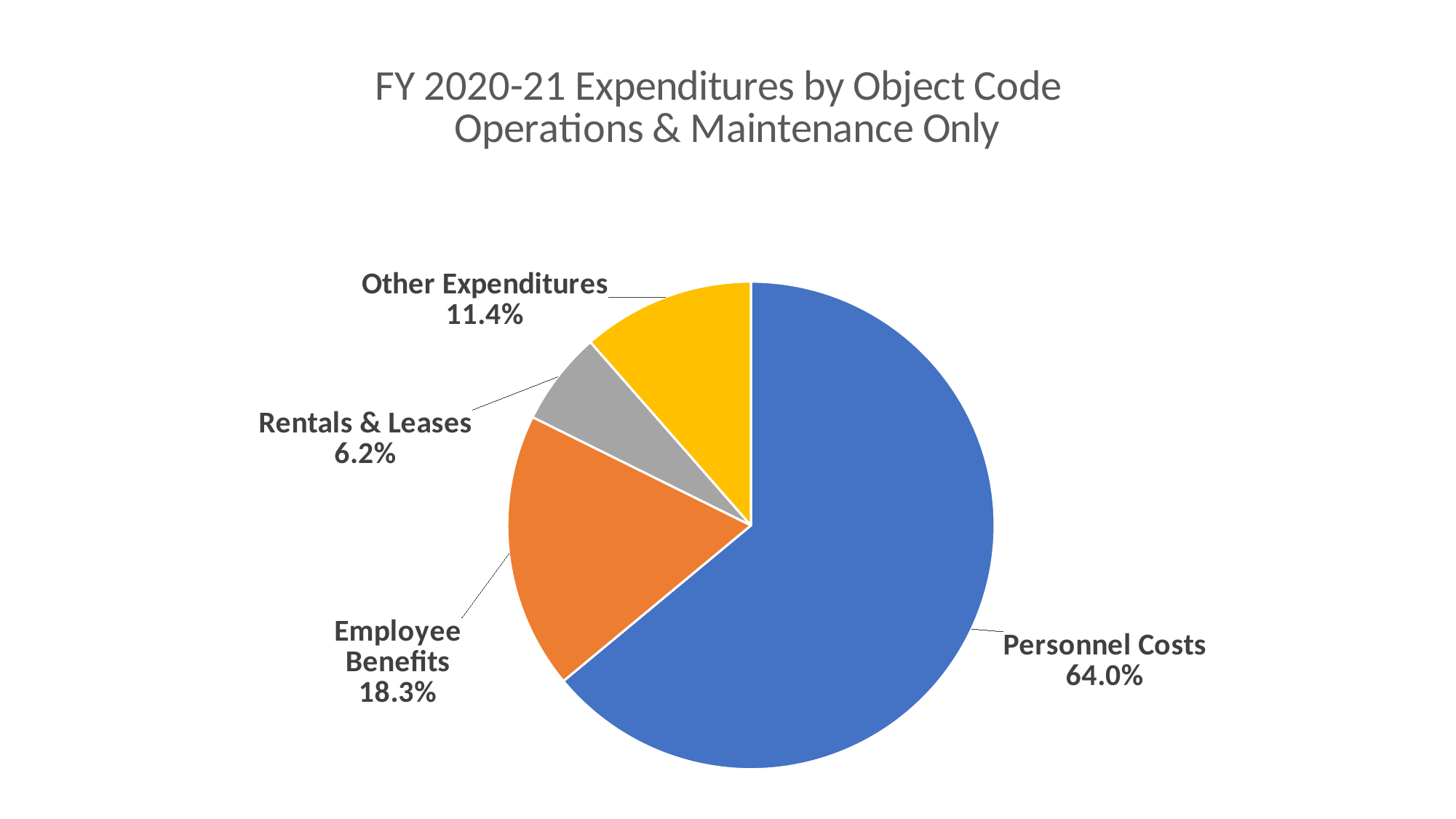
What share of expenditures is Personnel Costs? 64.0% How many categories are shown in the pie chart? 4 What is the difference in percentage points between Personnel Costs and Employee Benefits? 45.7 Which category has the smallest share of expenditures? Rentals & Leases What share of expenditures is Rentals & Leases? 6.2% Which category has the largest share of expenditures? Personnel Costs What colour is the Employee Benefits slice? Orange What share of expenditures is Other Expenditures? 11.4% Which is larger, Other Expenditures or Rentals & Leases? Other Expenditures What kind of chart is shown on the slide? Pie chart What share of expenditures is Employee Benefits? 18.3% What is the title of the chart? FY 2020-21 Expenditures by Object Code Operations & Maintenance Only